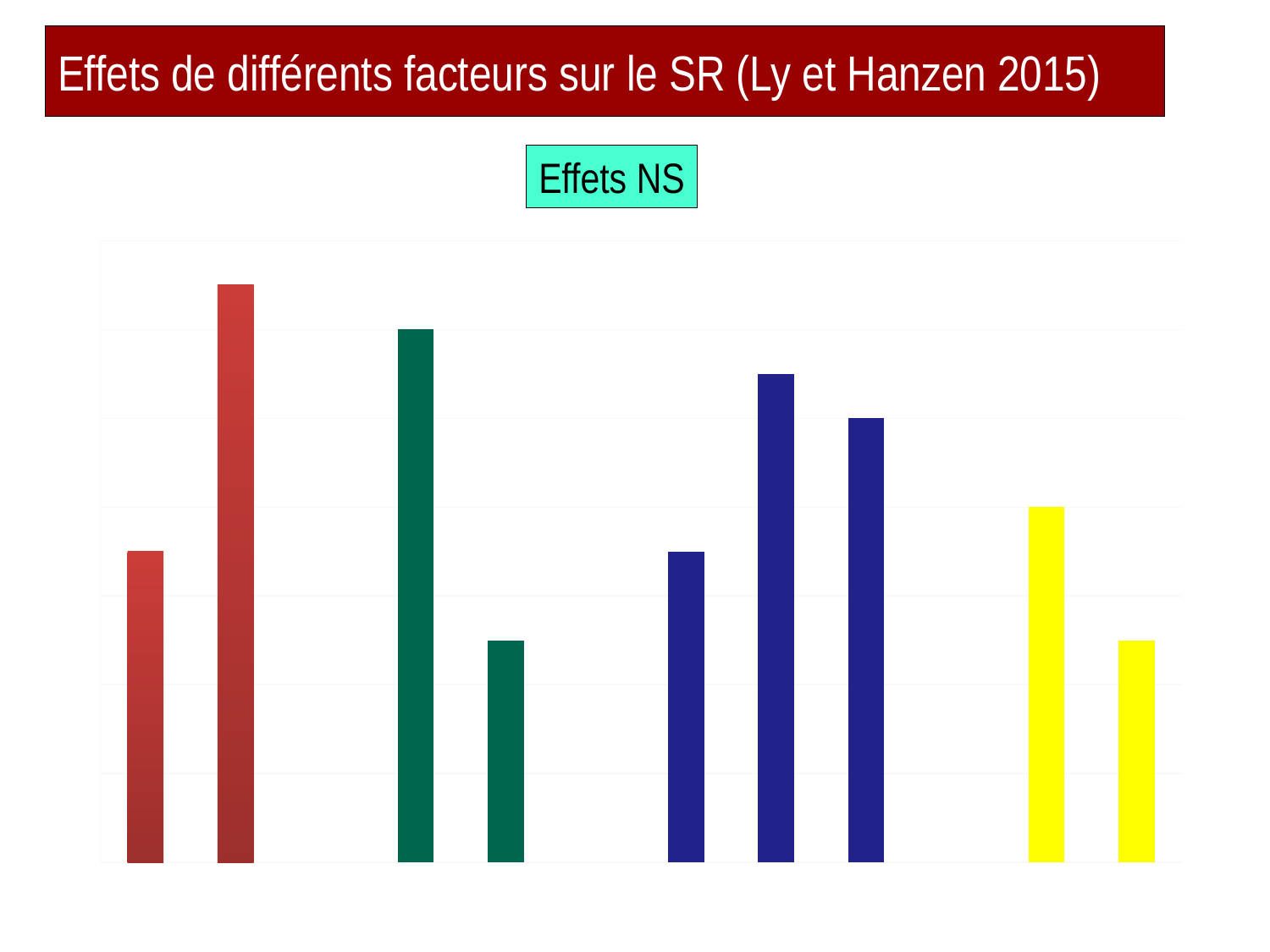
Among the two green bars, is the left one taller or shorter than the right one? taller How many different bar colours are used in the chart? 4 What colour is the tallest bar in the chart? red Among the three blue bars, which one is the tallest: the first, second or third from the left? second Is the first bar from the left taller or shorter than the second bar from the left? shorter What text appears in the box above the chart? Effets NS How many red bars are there in the chart? 2 What kind of chart is shown on the slide? bar chart How many blue bars are there in the chart? 3 How many bars are plotted in the chart? 9 Among the two yellow bars, is the left one taller or shorter than the right one? taller